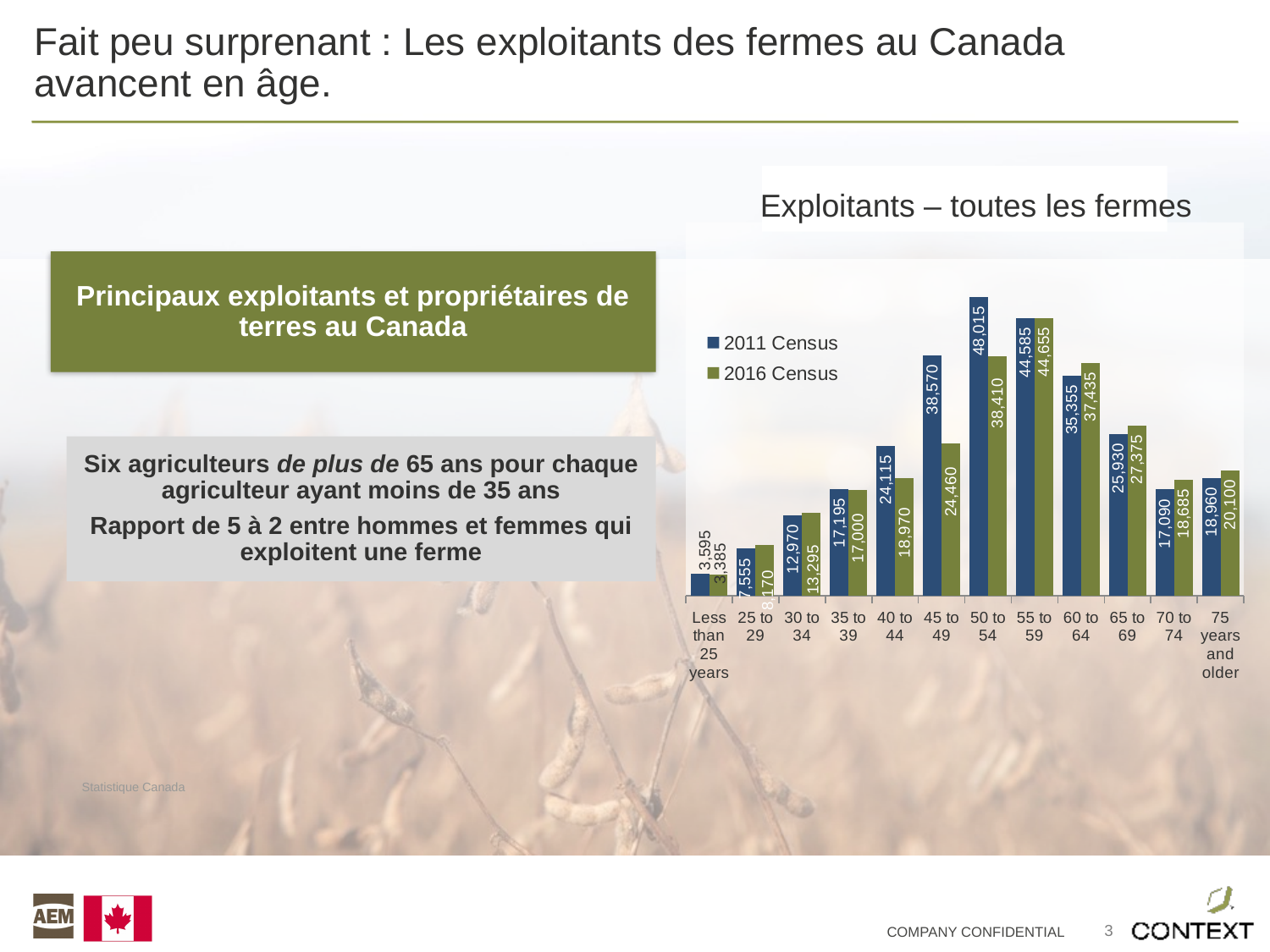
Which age group has the lowest 2016 Census value? Less than 25 years How many series does the legend list? 2 What is the title of the chart? Exploitants – toutes les fermes What is the 2016 Census value for the 45 to 49 age group? 24,460 What type of chart is shown on the slide? Bar chart Which age group has the highest 2016 Census value? 55 to 59 How many age categories are shown on the x axis? 12 What is the difference between the 2011 Census and 2016 Census values for the 45 to 49 age group? 14,110 For the 65 to 69 age group, which is larger: the 2011 Census value or the 2016 Census value? 2016 Census What is the 2016 Census value for the 75 years and older group? 20,100 Which age group has the highest 2011 Census value? 50 to 54 What is the 2011 Census value for the 50 to 54 age group? 48,015